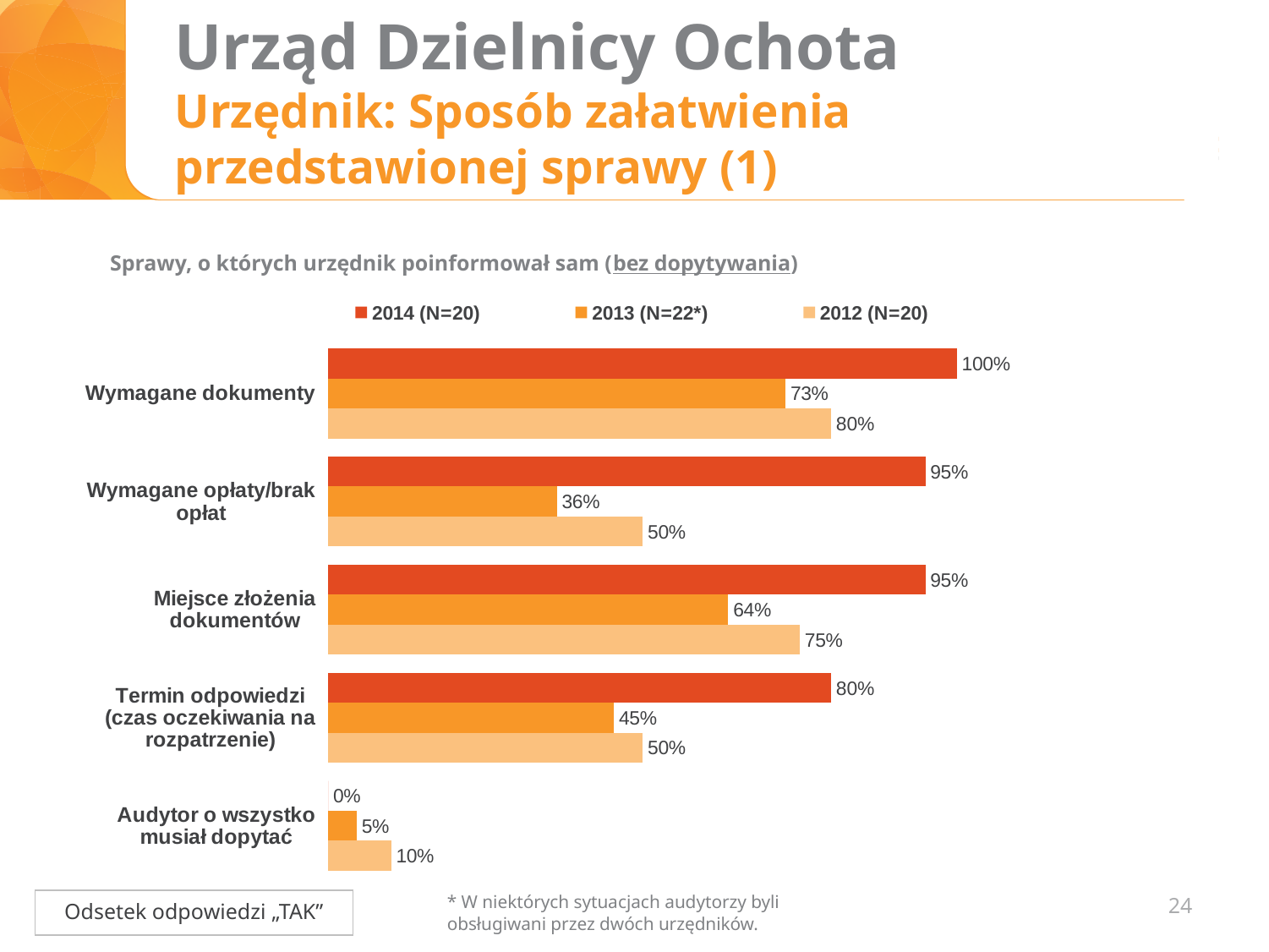
What is the value for Audytor o wszystko musiał dopytać in the 2014 (N=20) series? 0% What kind of chart is shown on the slide? Bar chart Which category has the highest value in the 2013 (N=22*) series? Wymagane dokumenty What is the subtitle text shown above the chart? Sprawy, o których urzędnik poinformował sam (bez dopytywania) What is the value for Wymagane opłaty/brak opłat in the 2013 (N=22*) series? 36% For Wymagane dokumenty, which is larger: the 2013 (N=22*) value or the 2012 (N=20) value? 2012 (N=20) Which category has the lowest value in the 2012 (N=20) series? Audytor o wszystko musiał dopytać How many categories are shown on the chart? 5 How many series does the legend list? 3 What is the difference between the 2014 (N=20) and 2013 (N=22*) values for Termin odpowiedzi (czas oczekiwania na rozpatrzenie)? 35 percentage points What is the value for Miejsce złożenia dokumentów in the 2012 (N=20) series? 75% What is the value for Wymagane dokumenty in the 2014 (N=20) series? 100%